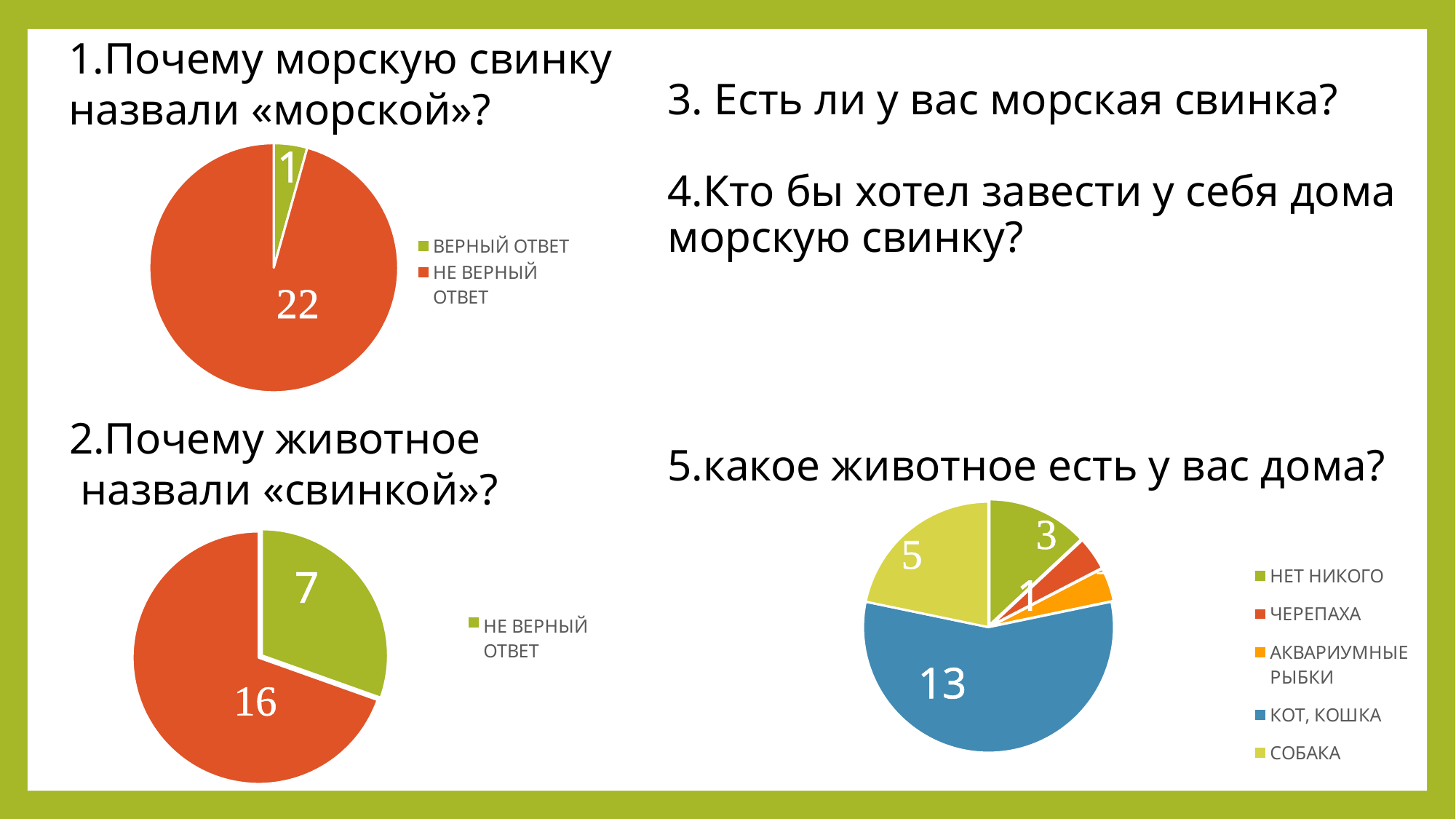
In the chart for question 5 ("какое животное есть у вас дома?"), what is the value for СОБАКА? 5 In the chart for question 1 ("Почему морскую свинку назвали «морской»?"), which category is the largest? НЕ ВЕРНЫЙ ОТВЕТ In the chart for question 2 ("Почему животное назвали «свинкой»?"), what is the difference between the two slice values? 9 In the chart for question 2 ("Почему животное назвали «свинкой»?"), what value is shown on the orange slice? 16 In the chart for question 2 ("Почему животное назвали «свинкой»?"), what value is shown on the green slice? 7 In the chart for question 1 ("Почему морскую свинку назвали «морской»?"), what is the value for ВЕРНЫЙ ОТВЕТ? 1 In the chart for question 1 ("Почему морскую свинку назвали «морской»?"), what is the difference between НЕ ВЕРНЫЙ ОТВЕТ and ВЕРНЫЙ ОТВЕТ? 21 In the chart for question 5 ("какое животное есть у вас дома?"), which category is the largest? КОТ, КОШКА In the chart for question 1 ("Почему морскую свинку назвали «морской»?"), what is the value for НЕ ВЕРНЫЙ ОТВЕТ? 22 In the chart for question 5 ("какое животное есть у вас дома?"), what is the value for КОТ, КОШКА? 13 What kind of chart is shown for question 1 ("Почему морскую свинку назвали «морской»?")? Pie chart How many categories does the legend list in the chart for question 5 ("какое животное есть у вас дома?")? 5